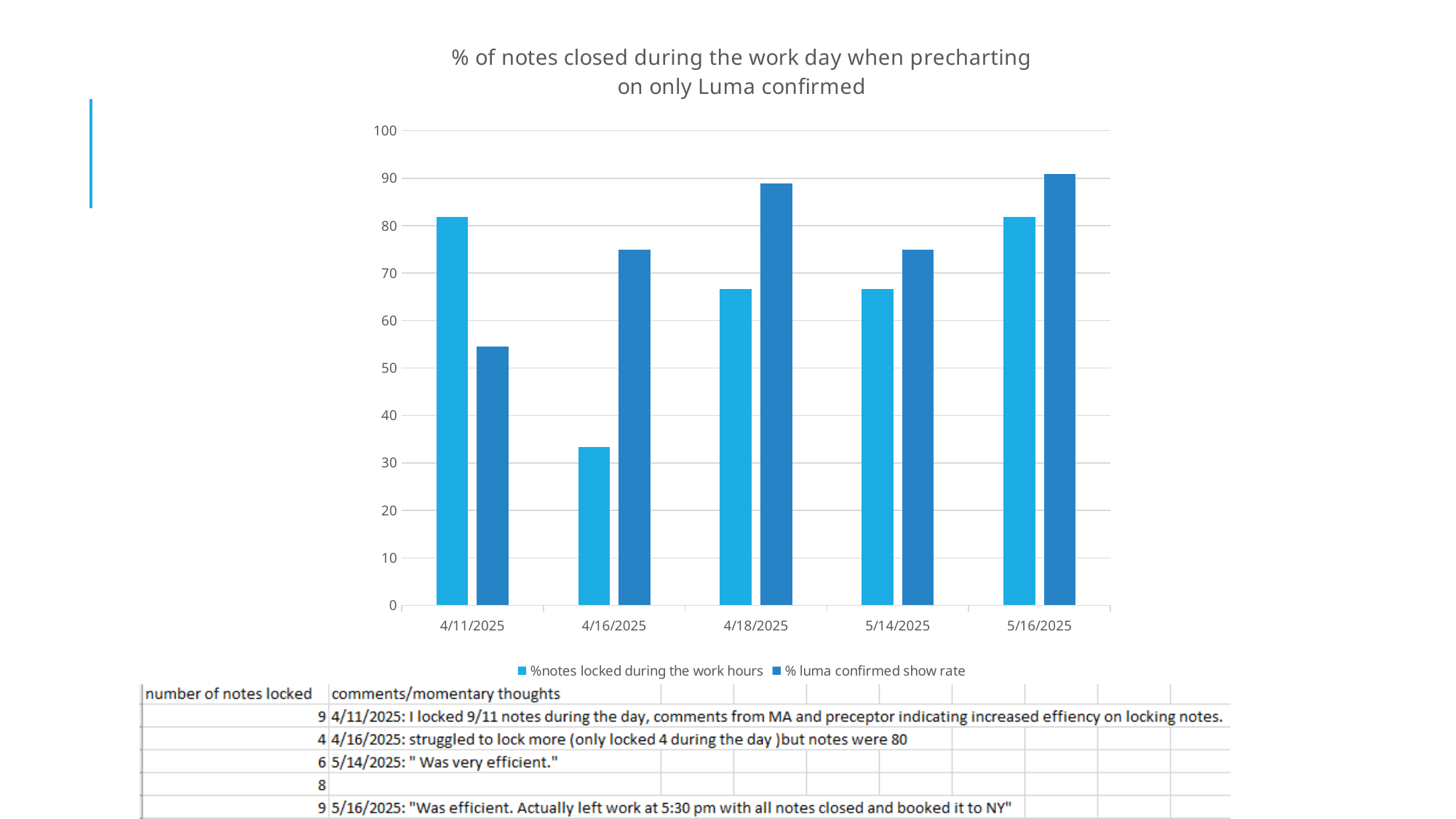
How many dates are shown on the x axis? 5 Is the value for '%notes locked during the work hours' on 4/16/2025 greater or less than 40? less On 4/16/2025, which series has the larger value: '%notes locked during the work hours' or '% luma confirmed show rate'? % luma confirmed show rate On which date is the value for '% luma confirmed show rate' lowest? 4/11/2025 What kind of chart is shown on the slide? bar chart Does the value for '%notes locked during the work hours' rise or fall from 4/11/2025 to 4/16/2025? fall Is the value for '%notes locked during the work hours' on 5/14/2025 greater or less than 60? greater How many series does the legend list? 2 On 4/11/2025, which series has the larger value: '%notes locked during the work hours' or '% luma confirmed show rate'? %notes locked during the work hours Is the value for '% luma confirmed show rate' on 4/18/2025 greater or less than 80? greater On which date is the value for '%notes locked during the work hours' lowest? 4/16/2025 What is the title of the chart? % of notes closed during the work day when precharting on only Luma confirmed